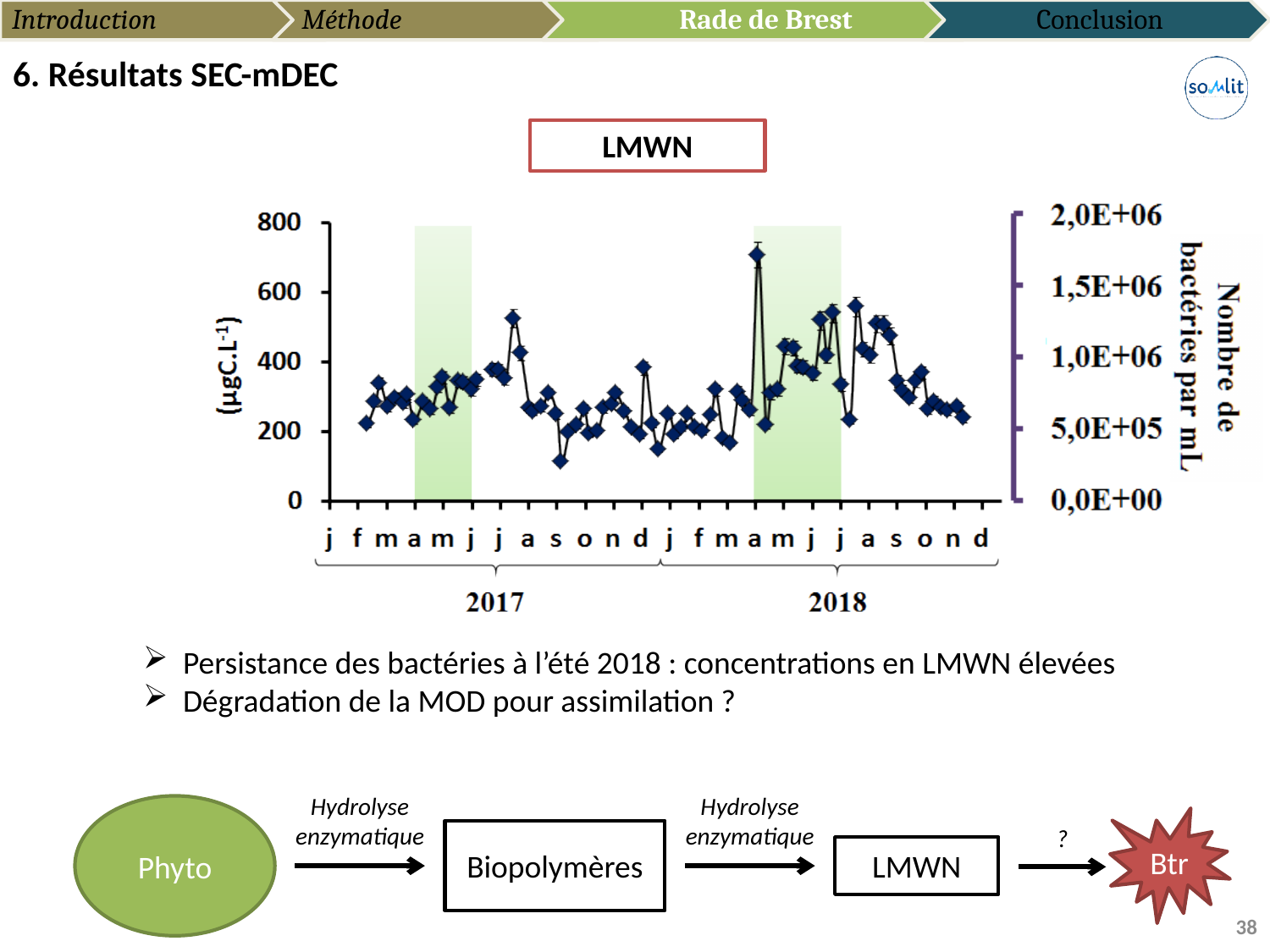
What is the label of the right-hand vertical axis of the chart? Nombre de bactéries par mL Is the highest peak in 2018 greater or less than 600 on the left axis? greater How many years are covered along the x axis of the chart? 2 What is the title shown above the chart? LMWN What kind of chart is shown on the slide? line chart Is the lowest point in 2017 greater or less than 200 on the left axis? less What is the highest tick value on the right vertical axis of the chart? 2,0E+06 Which years are labelled along the x axis of the chart? 2017 and 2018 Is the highest peak in 2017 greater or less than 600 on the left axis? less What is the highest tick value on the left vertical axis of the chart? 800 How many green shaded regions are highlighted on the chart? 2 Which year contains the highest point on the chart, 2017 or 2018? 2018